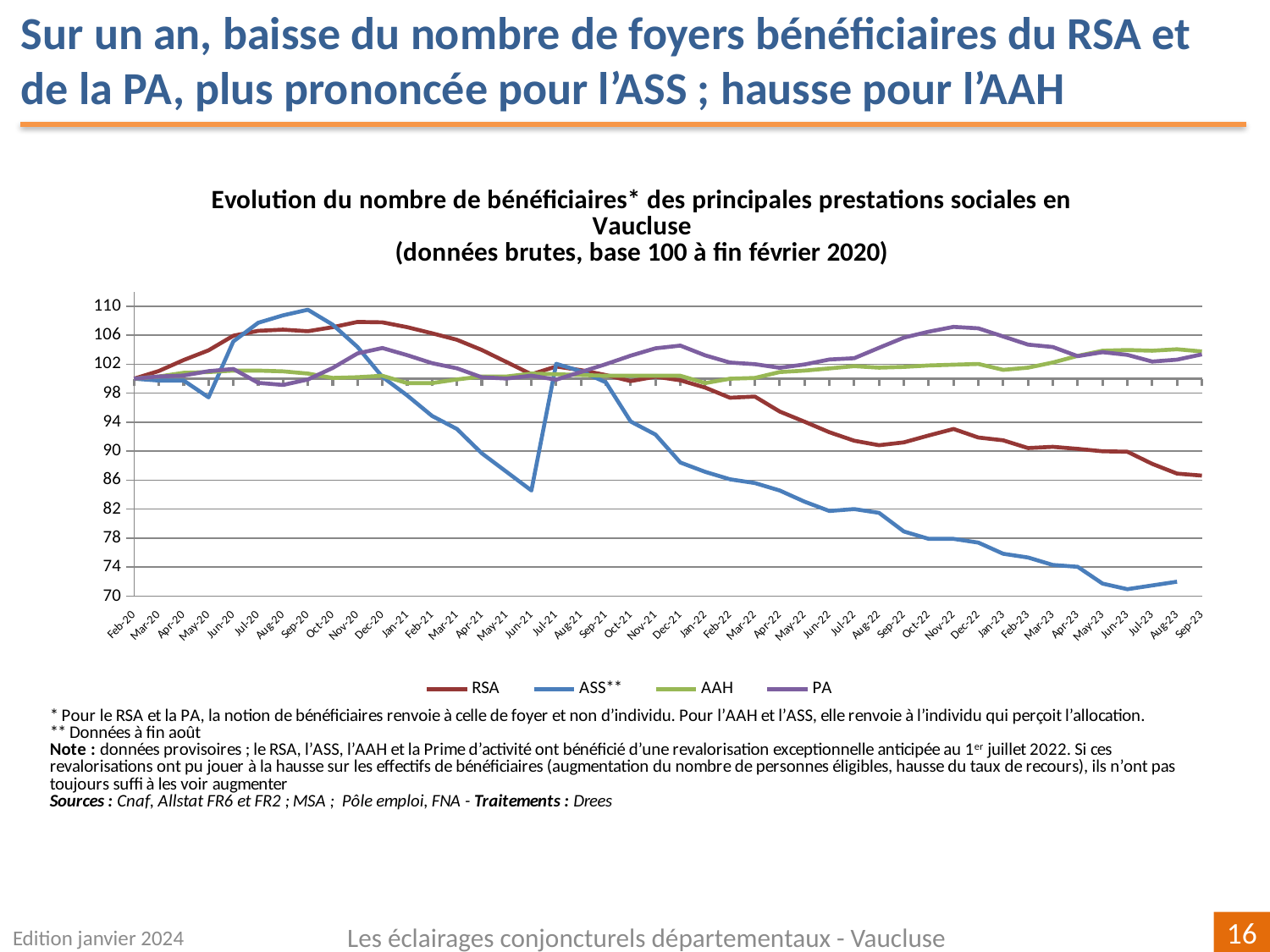
Which series are listed in the legend? RSA, ASS**, AAH, PA Which series has the highest value in Sep-20? ASS** Which series has the lowest value in Sep-23? RSA Is the value for PA in Nov-22 greater or less than 102? greater Is the value for RSA in Sep-23 greater or less than 90? less Is the value for ASS** in Sep-20 greater or less than 106? greater What kind of chart is shown on the slide? line chart In Sep-23, which is larger, the value for AAH or the value for RSA? AAH How many series does the legend list? 4 According to the chart title, which month is used as the base 100? fin février 2020